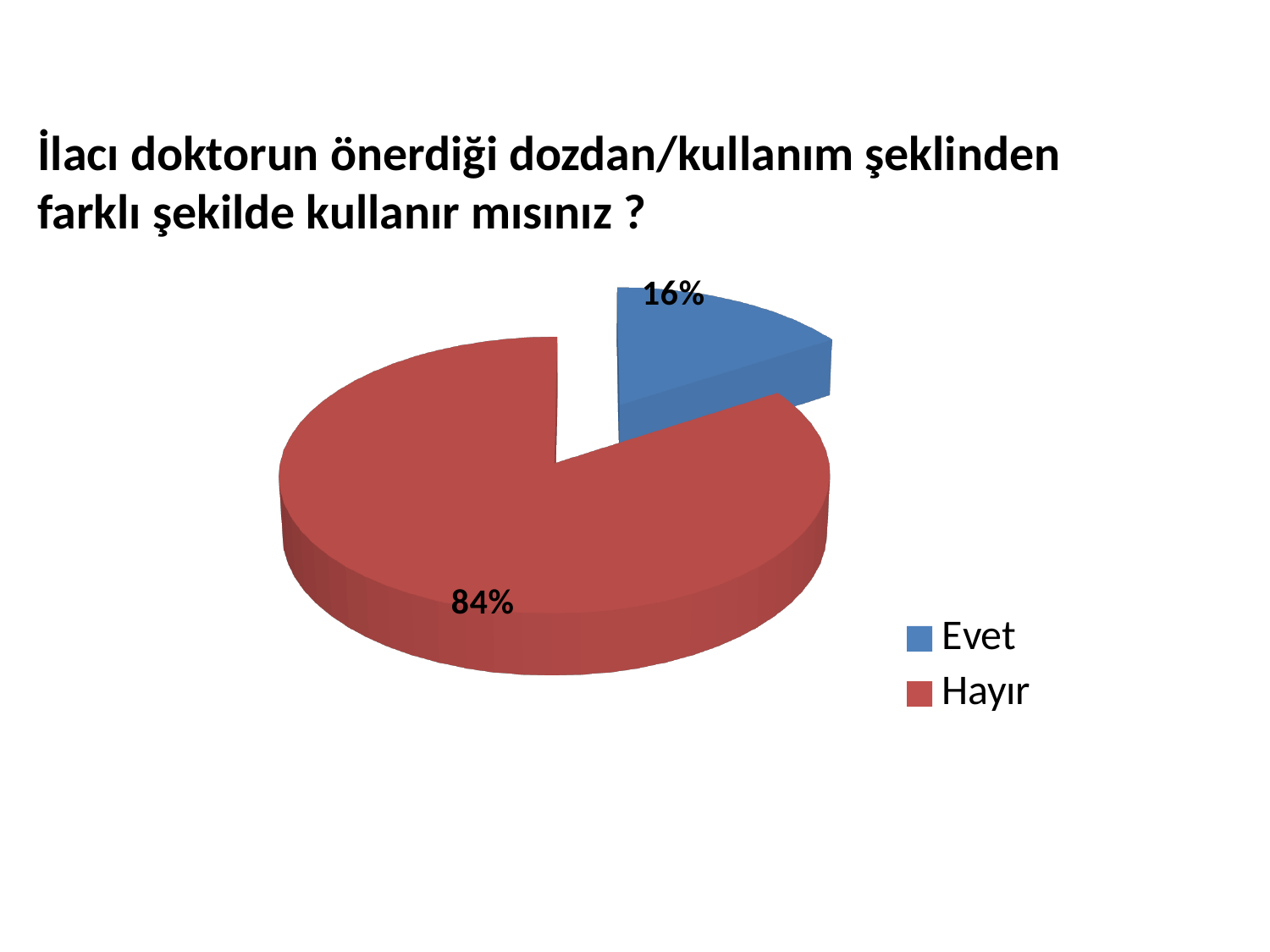
What percentage of respondents answered Evet? 16% What is the difference in percentage points between Hayır and Evet? 68 What colour is the Hayır slice? Red What kind of chart is shown on the slide? Pie chart How many entries does the legend list? 2 Which legend entry is shown in blue? Evet How many slices does the pie chart have? 2 Which is larger, the share for Evet or the share for Hayır? Hayır Which response has the largest share of the pie? Hayır What share of the pie does the Evet slice represent? 16% What percentage of respondents answered Hayır? 84% Which response has the smallest share of the pie? Evet